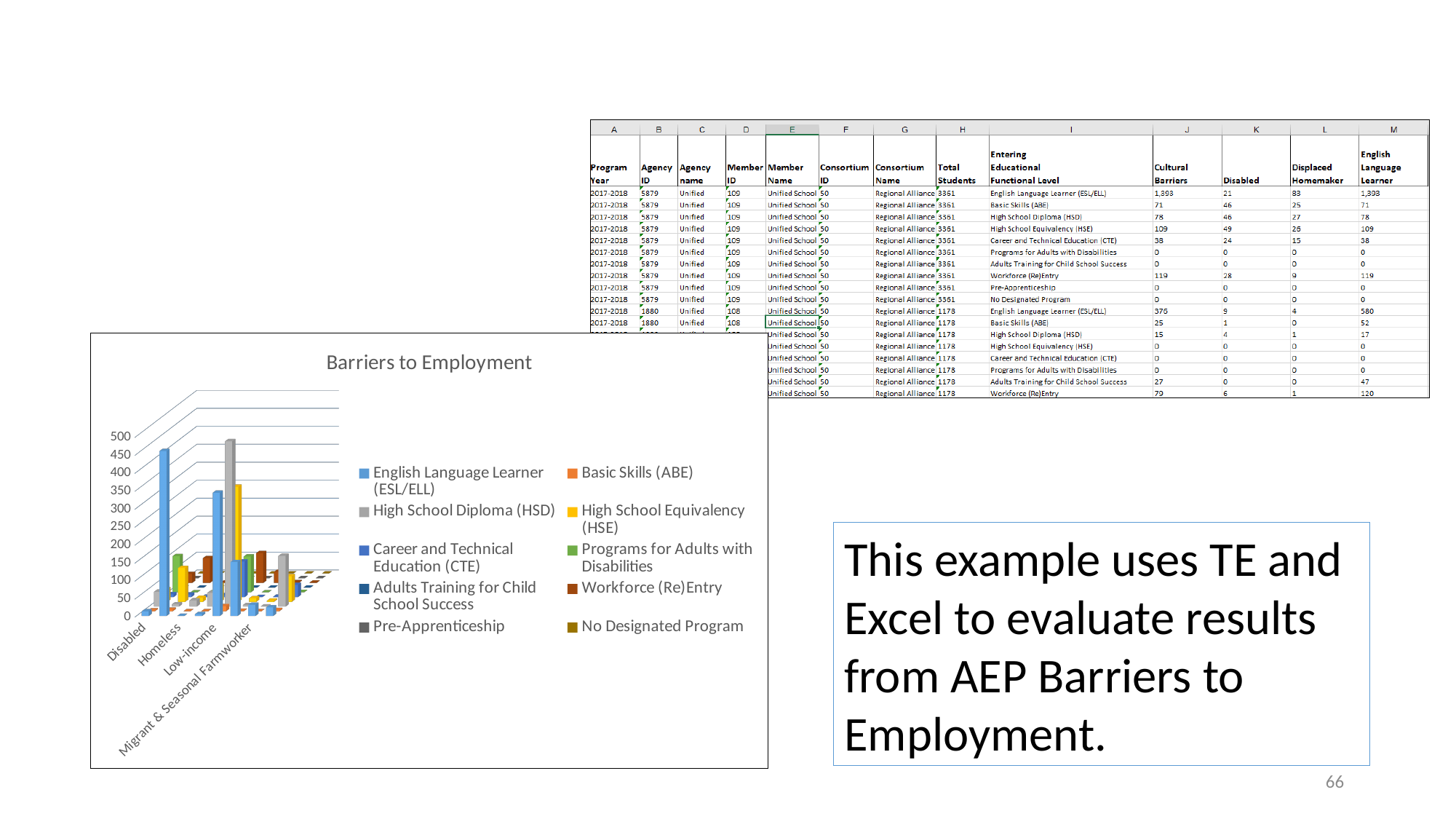
Is the English Language Learner (ESL/ELL) value for Disabled greater or less than 300? less Which category is listed last on the x axis of the chart? Migrant & Seasonal Farmworker How many series does the chart's legend list? 10 What is the highest value shown on the chart's vertical axis? 500 What is the title of the chart on the slide? Barriers to Employment What kind of chart is shown on the slide? bar chart Is the English Language Learner (ESL/ELL) value for Migrant & Seasonal Farmworker greater or less than 100? less